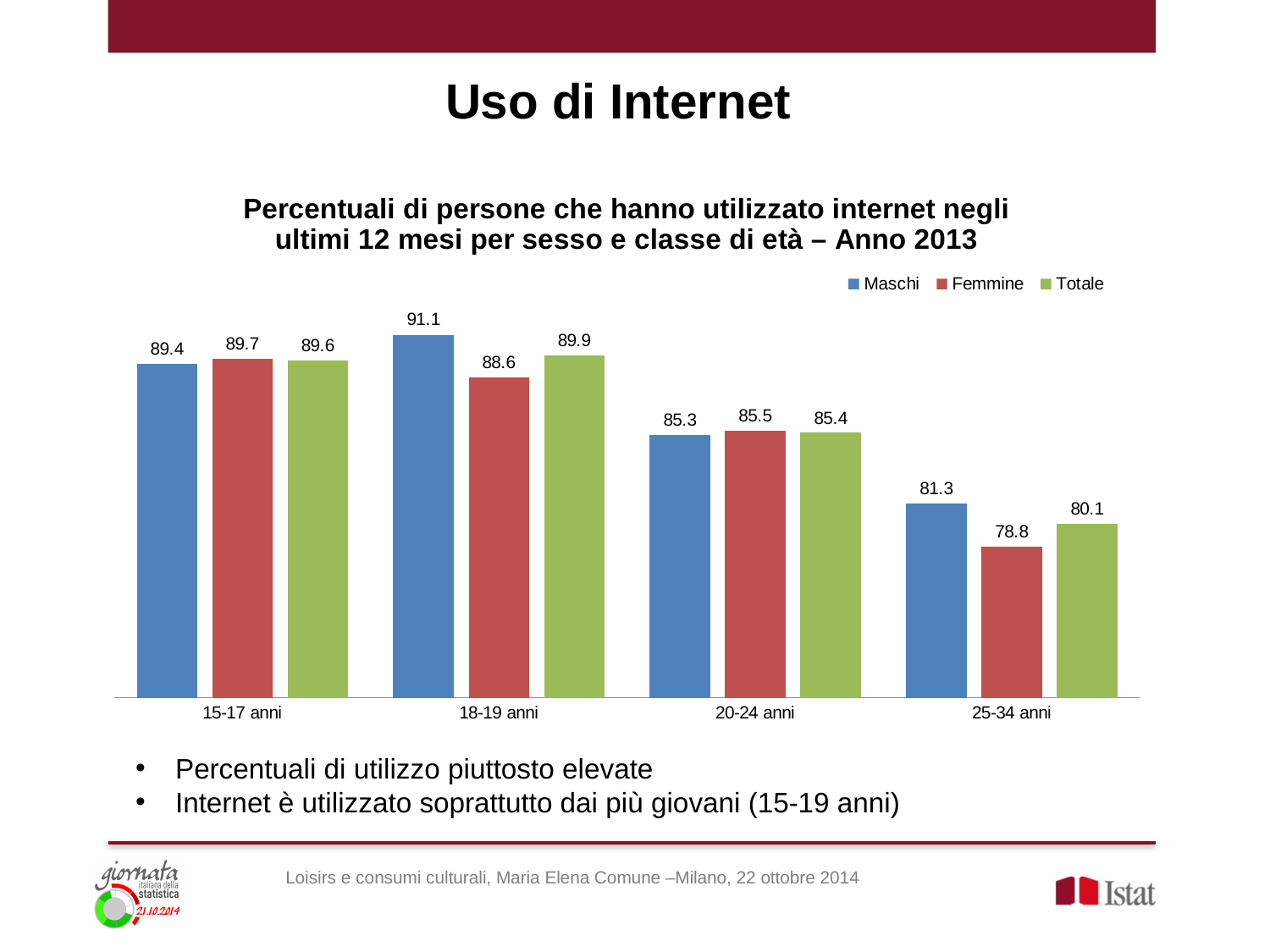
Which colour represents the Totale series? Green How many age groups are shown on the x axis? 4 How many series does the legend list? 3 What is the value for Femmine in the 25-34 anni age group? 78.8 What kind of chart is shown on the slide? Bar chart What is the value for Maschi in the 18-19 anni age group? 91.1 Which age group has the highest Maschi value? 18-19 anni Which is larger in the 15-17 anni age group, the Maschi value or the Femmine value? Femmine What is the Totale value for the 20-24 anni age group? 85.4 What is the difference between the Maschi and Femmine values in the 25-34 anni age group? 2.5 Do the Totale values rise or fall from the 18-19 anni group to the 25-34 anni group? Fall Which age group has the lowest Femmine value? 25-34 anni